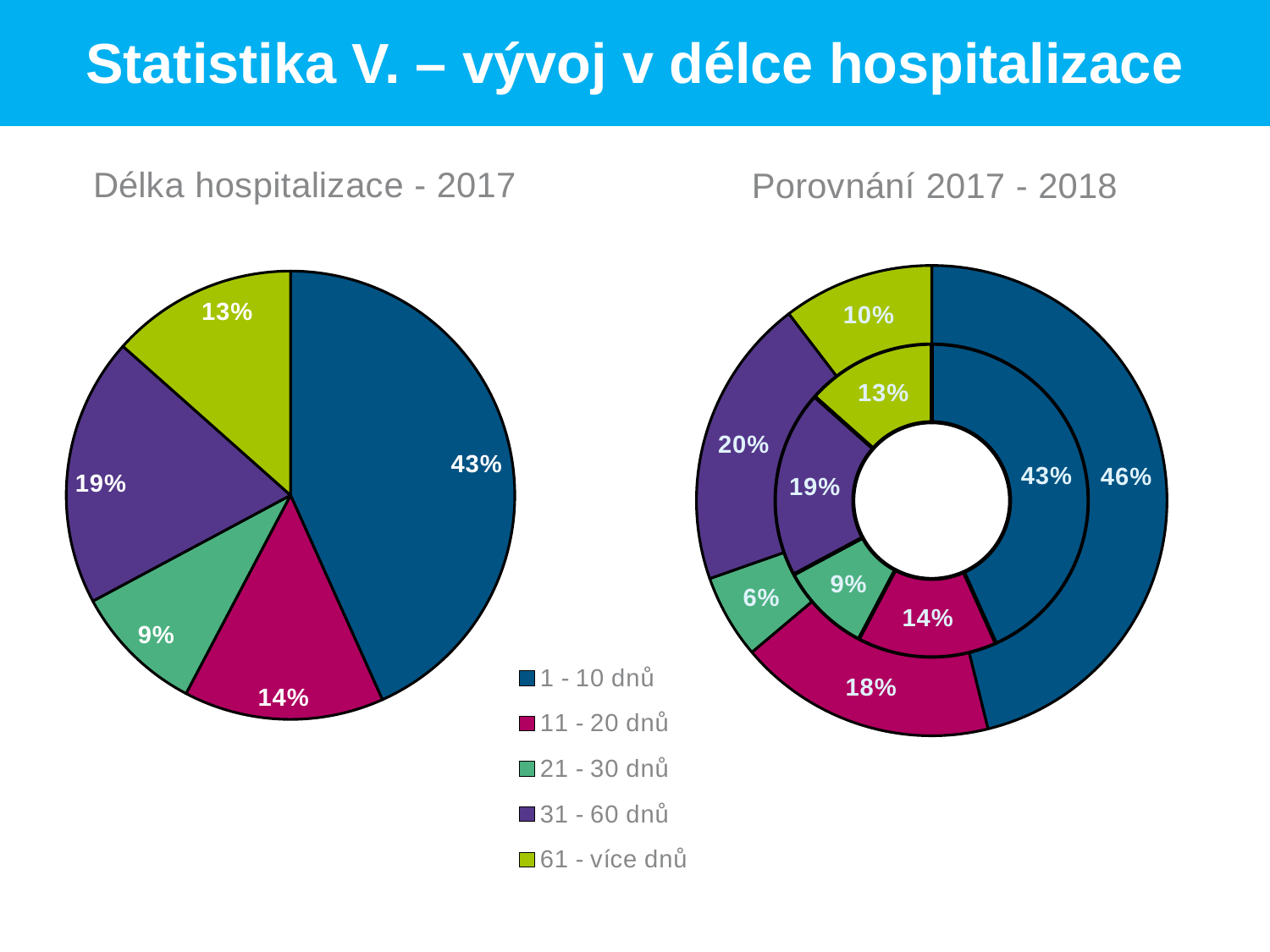
In the chart 'Porovnání 2017 - 2018', what share does the outer ring show for the '21 - 30 dnů' category? 6% In the chart 'Délka hospitalizace - 2017', what is the difference between the '31 - 60 dnů' share and the '61 - více dnů' share? 6% What kind of chart is 'Délka hospitalizace - 2017'? pie chart In the chart 'Délka hospitalizace - 2017', how many slices does the pie have? 5 In the chart 'Délka hospitalizace - 2017', what share is shown for the '21 - 30 dnů' category? 9% In the chart 'Délka hospitalizace - 2017', what share is shown for the '1 - 10 dnů' category? 43% In the chart 'Porovnání 2017 - 2018', what share does the outer ring show for the '1 - 10 dnů' category? 46% In the chart 'Porovnání 2017 - 2018', what is the difference between the outer ring and inner ring values for the '31 - 60 dnů' category? 1% In the chart 'Délka hospitalizace - 2017', which category has the smallest slice? 21 - 30 dnů How many entries does the legend on the slide list? 5 In the chart 'Délka hospitalizace - 2017', which category has the largest slice? 1 - 10 dnů In the chart 'Porovnání 2017 - 2018', which is larger for the '11 - 20 dnů' category: the inner ring value or the outer ring value? outer ring (18%)